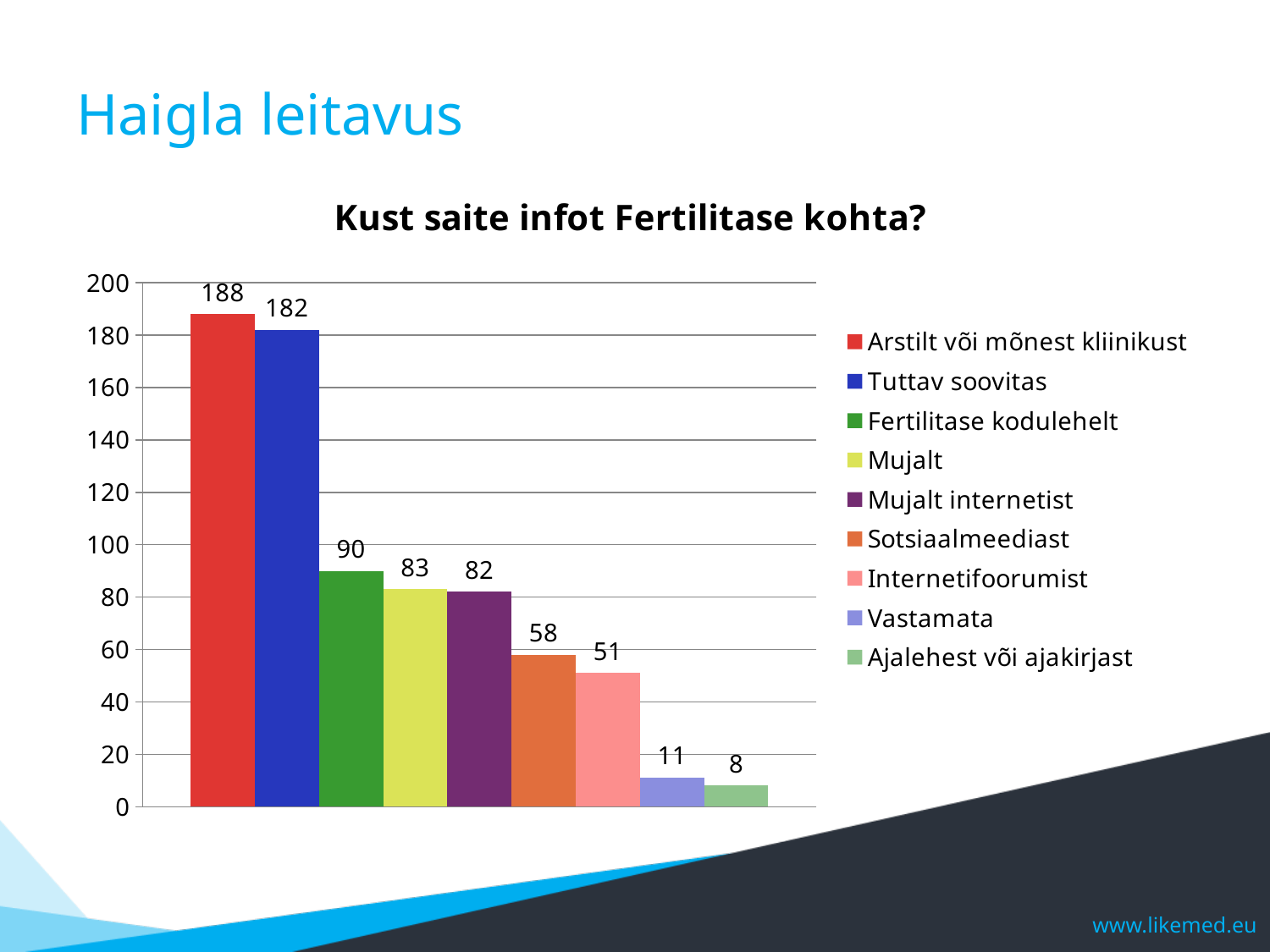
What is the value for Sotsiaalmeediast? 58 What is the value for Vastamata? 11 Which is larger, Mujalt or Mujalt internetist? Mujalt What is the difference between Tuttav soovitas and Internetifoorumist? 131 How many categories are shown in the chart? 9 Which category has the lowest value? Ajalehest või ajakirjast Is the value for Sotsiaalmeediast greater or less than 40? greater What is the title of the chart? Kust saite infot Fertilitase kohta? What kind of chart is shown on the slide? Bar chart What is the value for Fertilitase kodulehelt? 90 What is the value for Arstilt või mõnest kliinikust? 188 Which category has the highest value? Arstilt või mõnest kliinikust